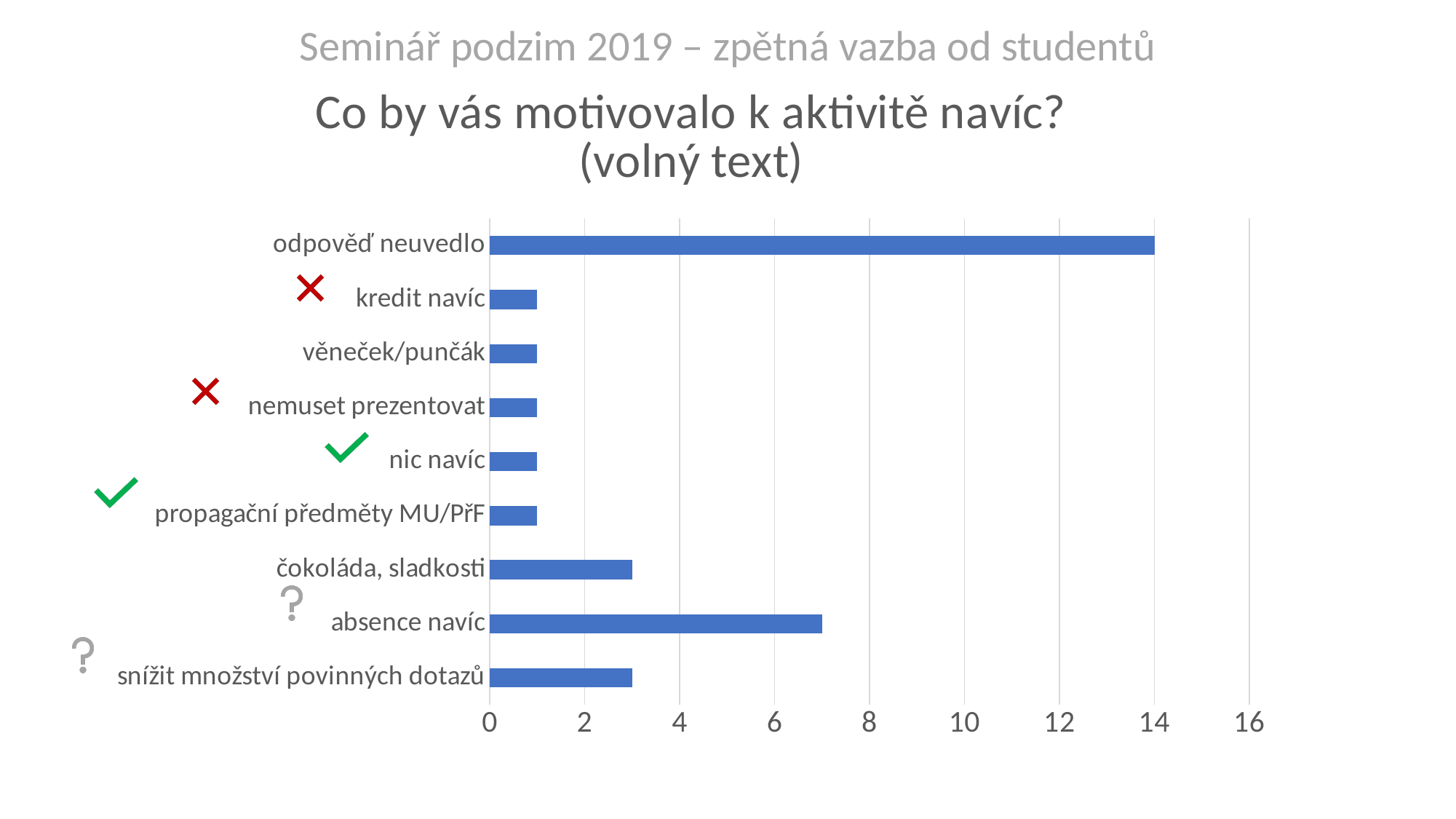
Is the value for 'snížit množství povinných dotazů' greater or less than 4? less Is the value for 'absence navíc' greater or less than 6? greater What type of chart is shown on the slide? bar chart Which is larger, the value for 'absence navíc' or the value for 'čokoláda, sladkosti'? absence navíc What is the highest value shown on the x axis of the chart? 16 Is the value for 'kredit navíc' greater or less than 2? less How many categories are plotted in the chart? 9 Which category has the highest value in the chart? odpověď neuvedlo Which is larger, the value for 'odpověď neuvedlo' or the value for 'absence navíc'? odpověď neuvedlo What is the value for 'odpověď neuvedlo'? 14